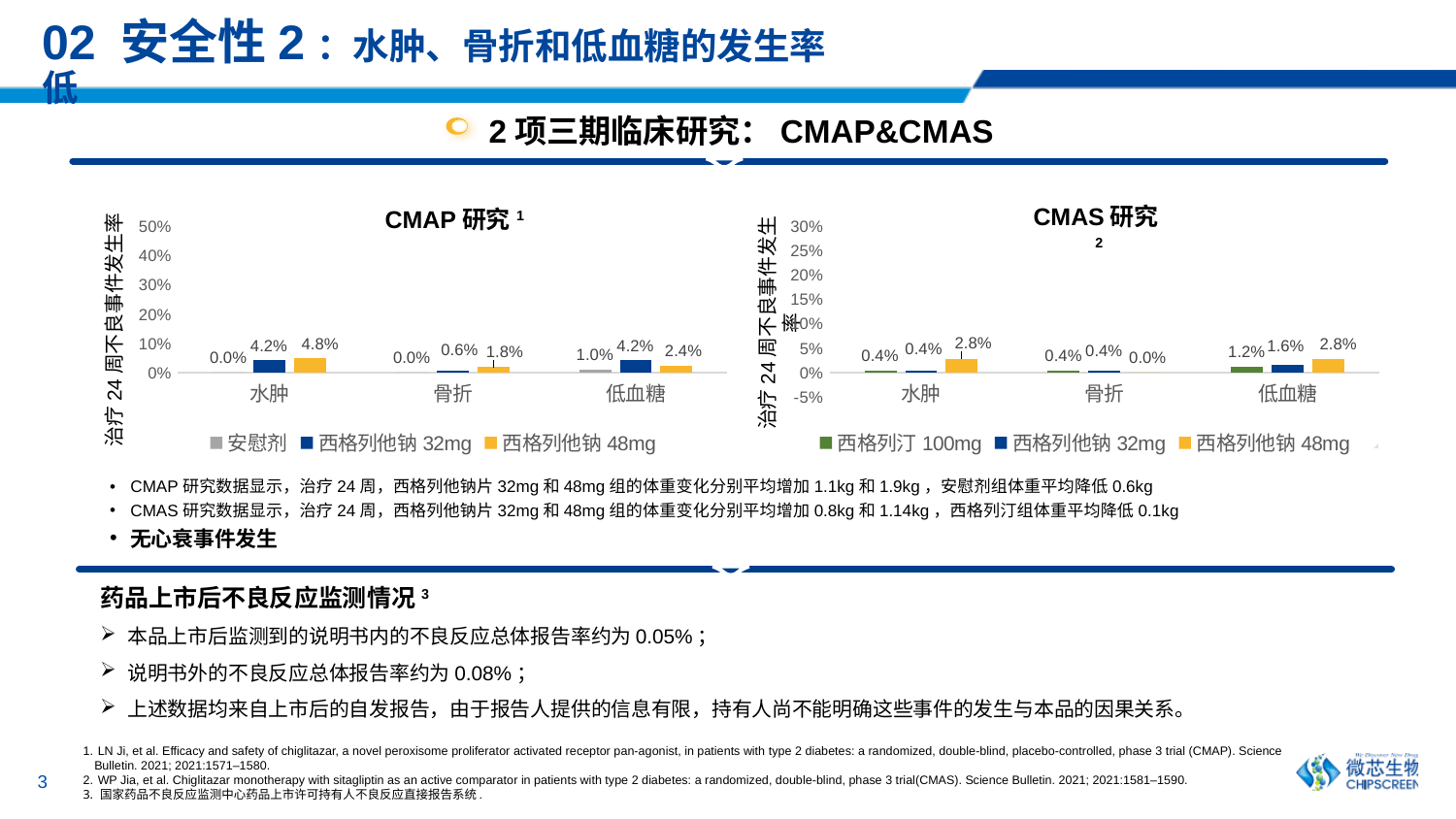
In the CMAS 研究 chart, which category has the lowest value for 西格列他钠 48mg? 骨折 In the CMAP 研究 chart, what is the value for 安慰剂 in the 低血糖 category? 1.0% What type of chart is the CMAP 研究 chart? bar chart In the CMAP 研究 chart, which category has the highest value for 西格列他钠 48mg? 水肿 How many series does the legend of the CMAP 研究 chart list? 3 How many categories are shown on the x axis of the CMAS 研究 chart? 3 In the CMAS 研究 chart, what is the value for 西格列汀 100mg in the 水肿 category? 0.4% In the CMAP 研究 chart, what is the difference between 西格列他钠 48mg and 西格列他钠 32mg in the 骨折 category? 1.2% In the CMAS 研究 chart, which is larger in the 低血糖 category: 西格列汀 100mg or 西格列他钠 32mg? 西格列他钠 32mg In the CMAP 研究 chart, what is the value for 西格列他钠 32mg in the 骨折 category? 0.6% In the CMAP 研究 chart, what is the value for 西格列他钠 48mg in the 水肿 category? 4.8% In the CMAS 研究 chart, what is the value for 西格列他钠 48mg in the 低血糖 category? 2.8%